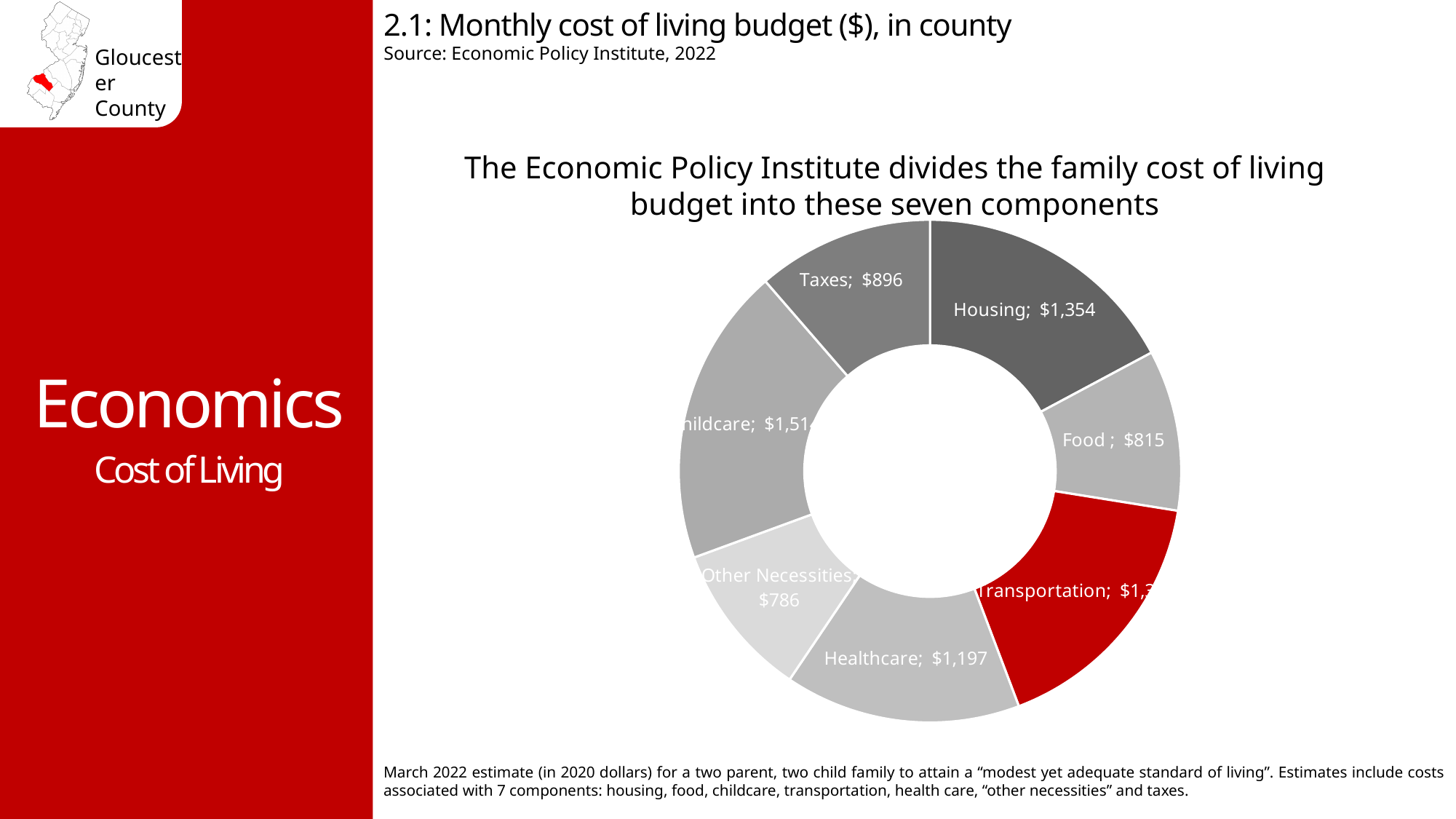
What is the monthly cost for Housing? $1,354 What is the difference between the Housing cost and the Taxes cost? $458 What type of chart is shown on the slide? Doughnut (pie) chart Which slice of the chart is coloured red? Transportation How many components (slices) does the chart show? 7 What is the monthly cost for Taxes? $896 What is the monthly cost for Food? $815 What is the monthly cost for Healthcare? $1,197 Which is larger, the monthly cost for Taxes or for Food? Taxes Which component has the smallest monthly cost? Other Necessities Which is larger, the monthly cost for Housing or for Healthcare? Housing What is the monthly cost for Other Necessities? $786